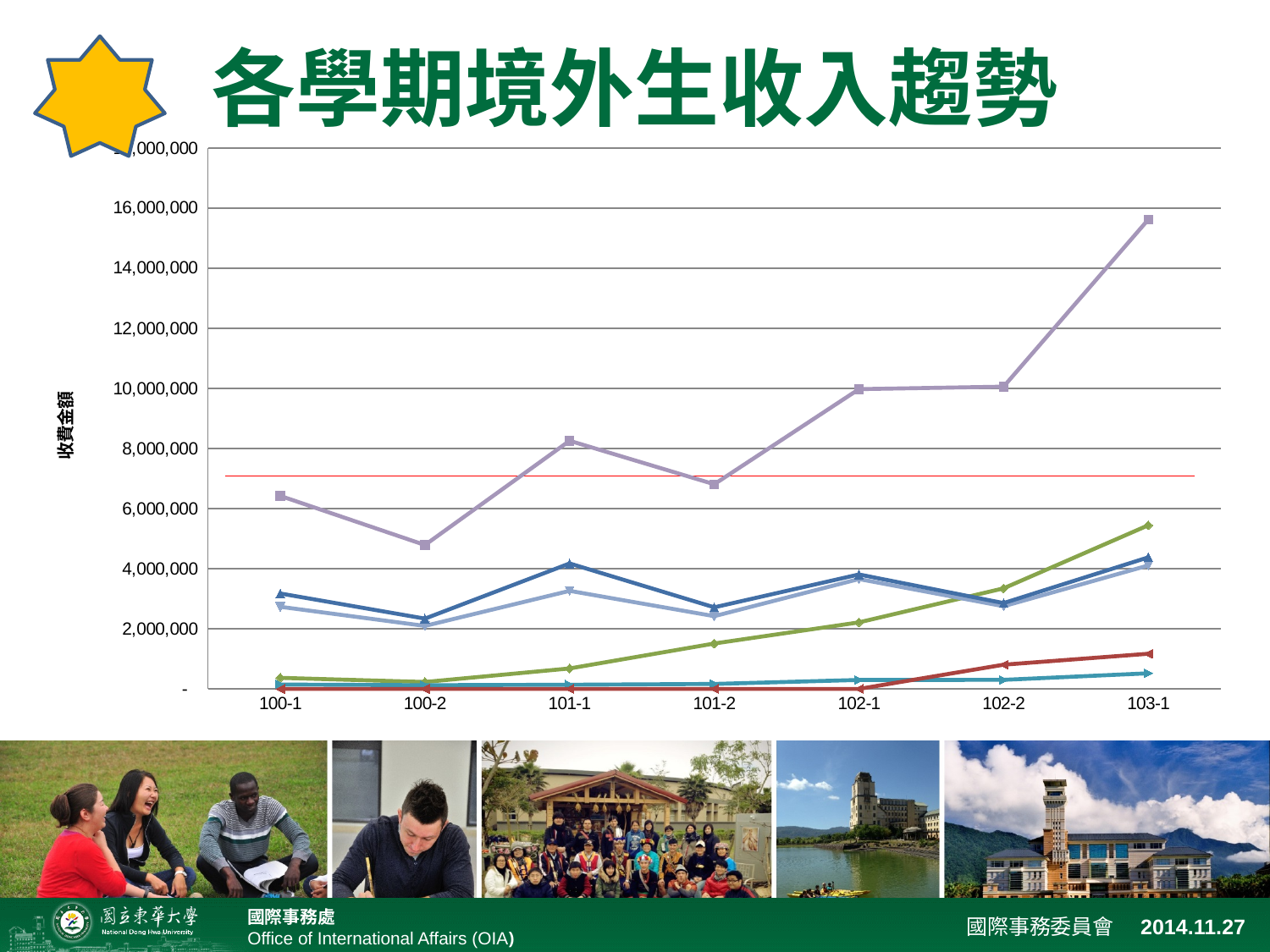
At 103-1, which is larger: the purple line with square markers or the green line with diamond markers? the purple line In which semester does the purple line with square markers reach its highest value? 103-1 Does the purple line with square markers rise or fall from 102-2 to 103-1? rise In which semester does the purple line with square markers reach its lowest value? 100-2 Is the value of the purple line with square markers at 103-1 greater or less than 14,000,000? greater What is the title of the chart on the slide? 各學期境外生收入趨勢 How many semesters are shown along the x axis of the chart? 7 Is the value of the purple line with square markers at 100-2 greater or less than 6,000,000? less What is the label on the vertical axis of the chart? 收費金額 Is the value of the green line with diamond markers at 103-1 greater or less than 4,000,000? greater What kind of chart is shown on the slide? line chart